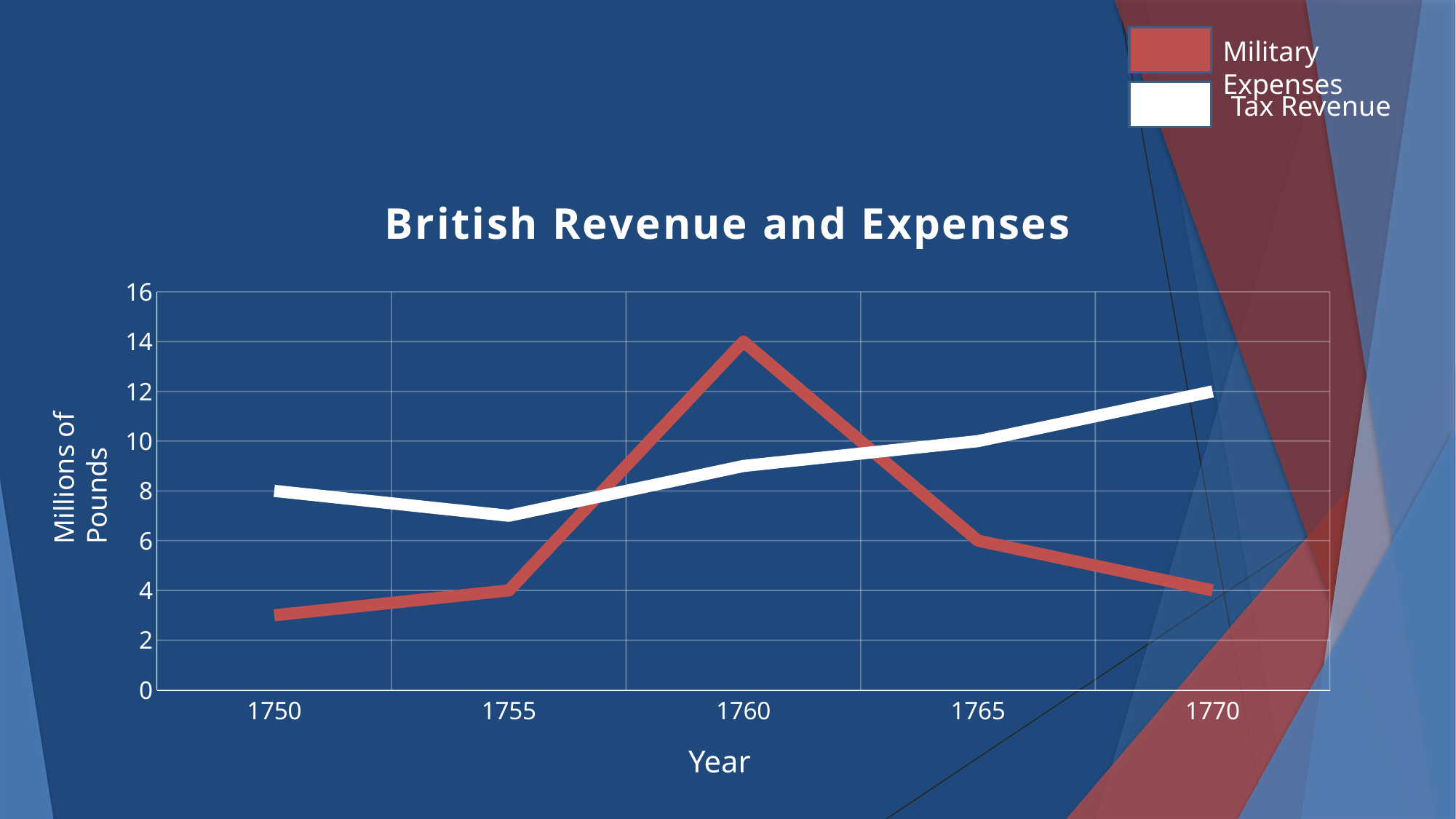
In which year are Military Expenses highest? 1760 How many series does the legend list? 2 In 1770, which is larger: Tax Revenue or Military Expenses? Tax Revenue What is the value of Military Expenses in 1760? 14 How many years are plotted along the x axis? 5 What is the value of Tax Revenue in 1770? 12 In which year is Tax Revenue lowest? 1755 Is the value for Military Expenses in 1750 greater or less than 4? less What is the title of the y axis? Millions of Pounds Does Tax Revenue rise or fall from 1755 to 1770? rise What kind of chart is shown on the slide? line chart In 1760, which is larger: Military Expenses or Tax Revenue? Military Expenses